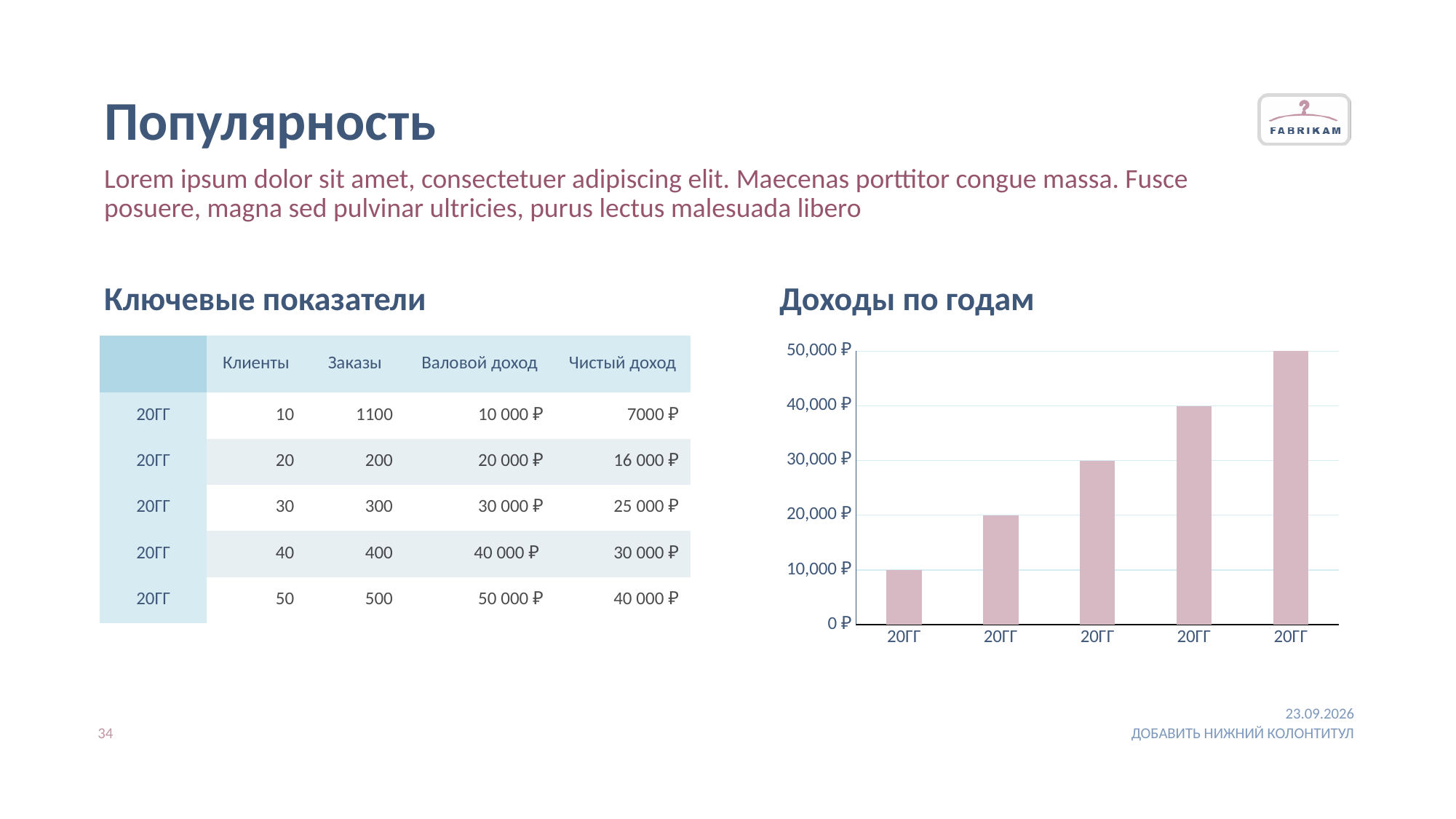
In the "Доходы по годам" chart, is the fourth bar from the left greater or less than 30,000 ₽? greater Do the bar values in the "Доходы по годам" chart rise or fall from left to right? rise In the "Доходы по годам" chart, which is taller: the second bar or the fourth bar? the fourth bar In the "Доходы по годам" chart, what value does the rightmost bar reach on the y axis? 50,000 ₽ In the "Доходы по годам" chart, what value does the leftmost bar reach on the y axis? 10,000 ₽ Which bar in the "Доходы по годам" chart is the tallest? the rightmost (fifth) bar What kind of chart is shown under the heading "Доходы по годам"? bar chart In the "Доходы по годам" chart, what value does the middle (third) bar reach on the y axis? 30,000 ₽ What label is shown under every bar on the x axis of the "Доходы по годам" chart? 20ГГ How many bars does the "Доходы по годам" chart have? 5 In the "Доходы по годам" chart, is the second bar from the left greater or less than 30,000 ₽? less Which bar in the "Доходы по годам" chart is the shortest? the leftmost (first) bar